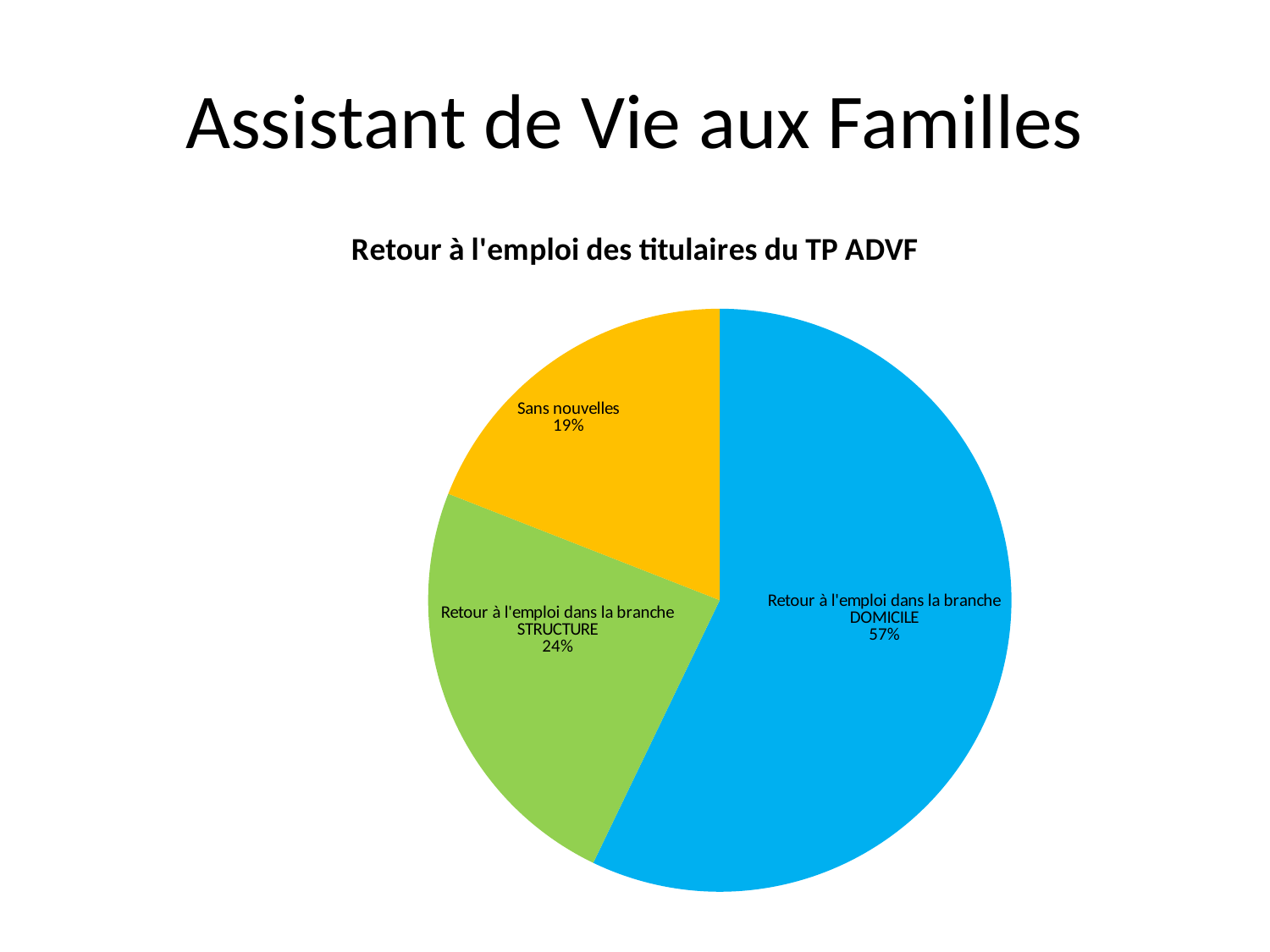
What is the difference in percentage points between the DOMICILE slice and the STRUCTURE slice? 33 What share of the pie is 'Retour à l'emploi dans la branche DOMICILE'? 57% What is the title of the chart? Retour à l'emploi des titulaires du TP ADVF What kind of chart is shown on the slide? pie chart Which slice of the pie is the largest? Retour à l'emploi dans la branche DOMICILE What colour is the 'Sans nouvelles' slice? yellow What share of the pie is 'Sans nouvelles'? 19% What share of the pie is 'Retour à l'emploi dans la branche STRUCTURE'? 24% Which is larger, the STRUCTURE slice or the 'Sans nouvelles' slice? Retour à l'emploi dans la branche STRUCTURE What is the difference in percentage points between the STRUCTURE slice and the 'Sans nouvelles' slice? 5 How many slices does the pie chart have? 3 Which slice of the pie is the smallest? Sans nouvelles